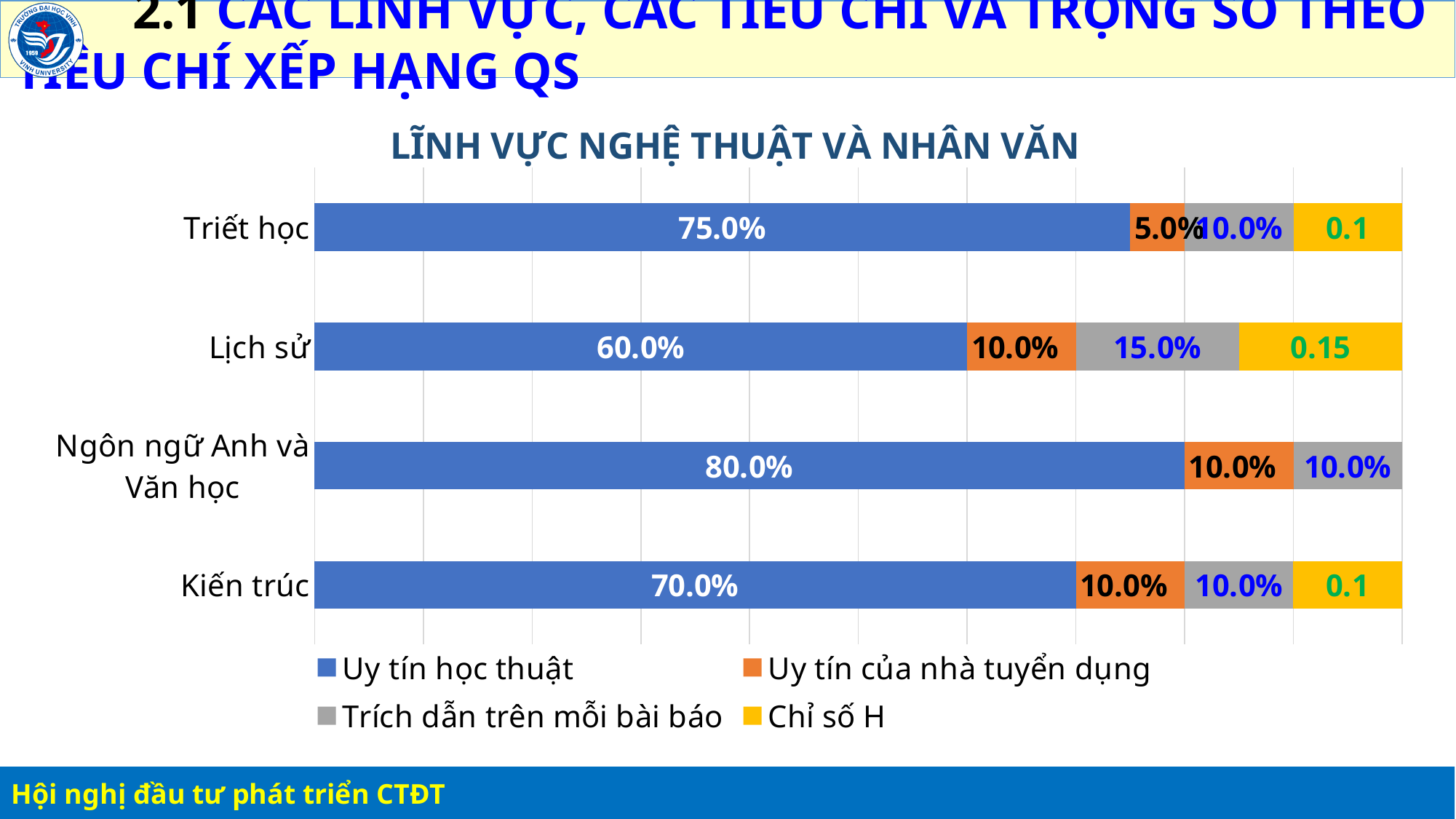
What is the Uy tín của nhà tuyển dụng value for Triết học? 5.0% What is the difference between the Uy tín học thuật values for Ngôn ngữ Anh và Văn học and Lịch sử? 20.0% How many series does the legend list? 4 What is the title of the chart? LĨNH VỰC NGHỆ THUẬT VÀ NHÂN VĂN What is the Chỉ số H value for Lịch sử? 0.15 What type of chart is shown on the slide? Stacked bar chart What is the Trích dẫn trên mỗi bài báo value for Lịch sử? 15.0% Which category has the lowest Uy tín học thuật value? Lịch sử What is the Uy tín học thuật value for Triết học? 75.0% Which is larger, the Uy tín học thuật value for Triết học or for Kiến trúc? Triết học How many categories are shown on the chart? 4 Which category has the highest Uy tín học thuật value? Ngôn ngữ Anh và Văn học